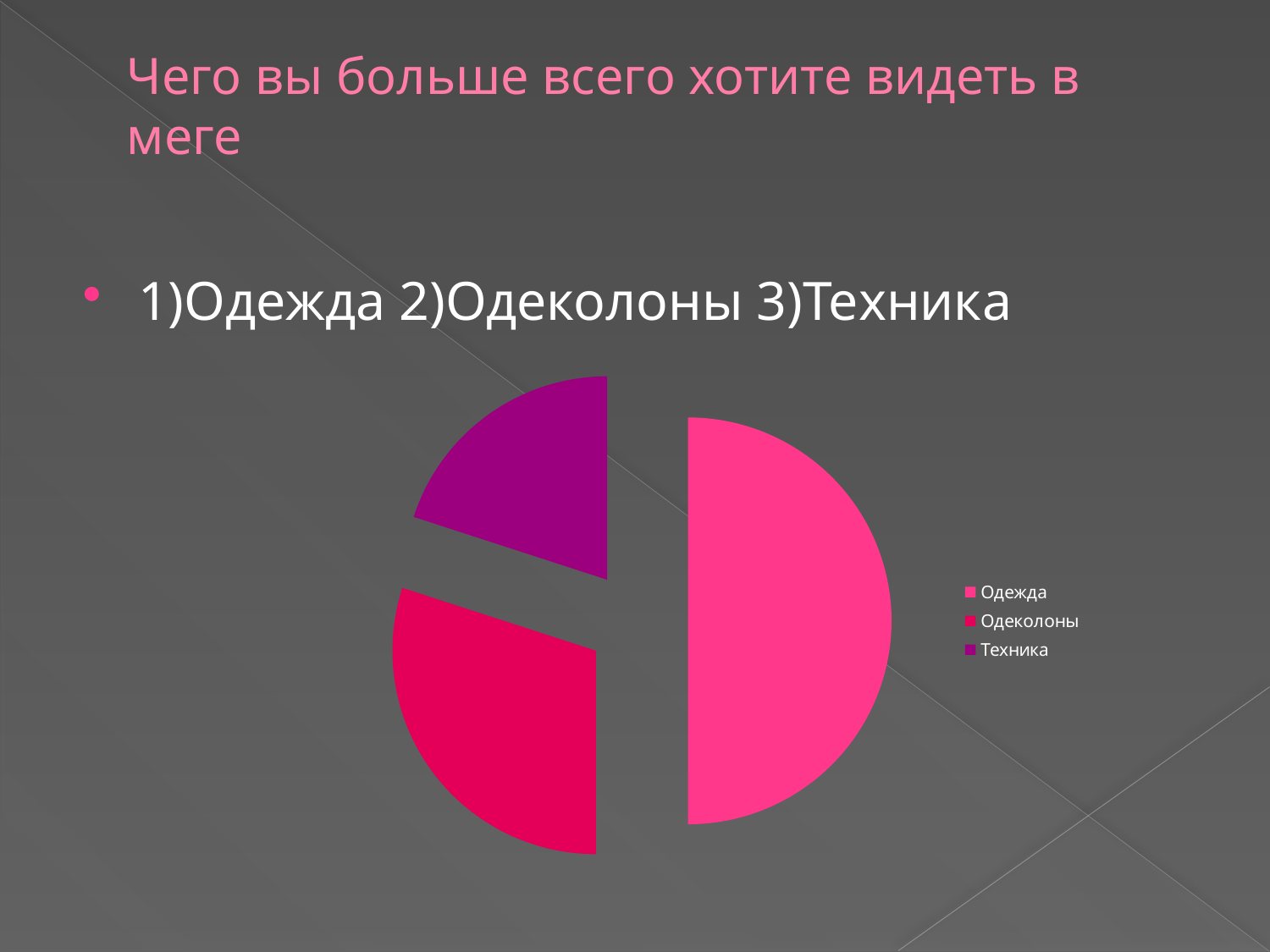
Which category has the largest slice in the pie chart? Одежда What kind of chart is shown on the slide? pie chart Which slice is larger in the pie chart, Одежда or Одеколоны? Одежда Which slice is larger in the pie chart, Одеколоны or Техника? Одеколоны Which category has the smallest slice in the pie chart? Техника What colour is the Техника slice in the pie chart? purple How many entries does the legend of the pie chart list? 3 How many slices does the pie chart have? 3 Which legend entry is listed first in the pie chart's legend? Одежда